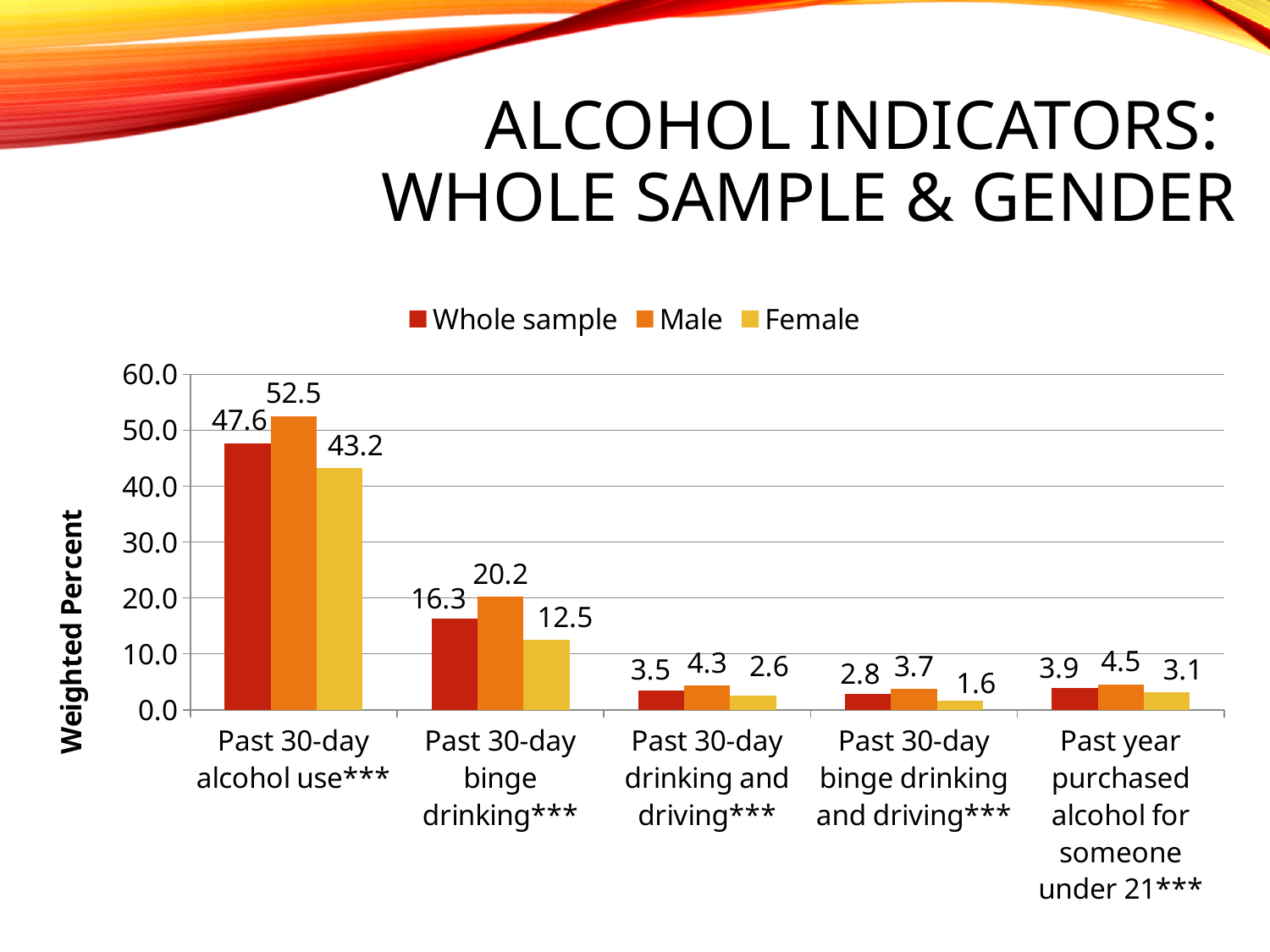
What is the label of the vertical axis? Weighted Percent What is the Female value for Past 30-day binge drinking? 12.5 Which category has the highest Whole sample value? Past 30-day alcohol use What is the Male value for Past 30-day alcohol use? 52.5 How many series does the legend list? 3 What is the Whole sample value for Past year purchased alcohol for someone under 21? 3.9 Which category has the lowest Female value? Past 30-day binge drinking and driving Which is larger for Past 30-day binge drinking: the Male value or the Female value? Male What kind of chart is shown on the slide? Bar chart Is the Whole sample value for Past 30-day alcohol use greater or less than 40.0? greater What is the difference between the Male and Female values for Past 30-day alcohol use? 9.3 How many categories are shown on the x axis? 5